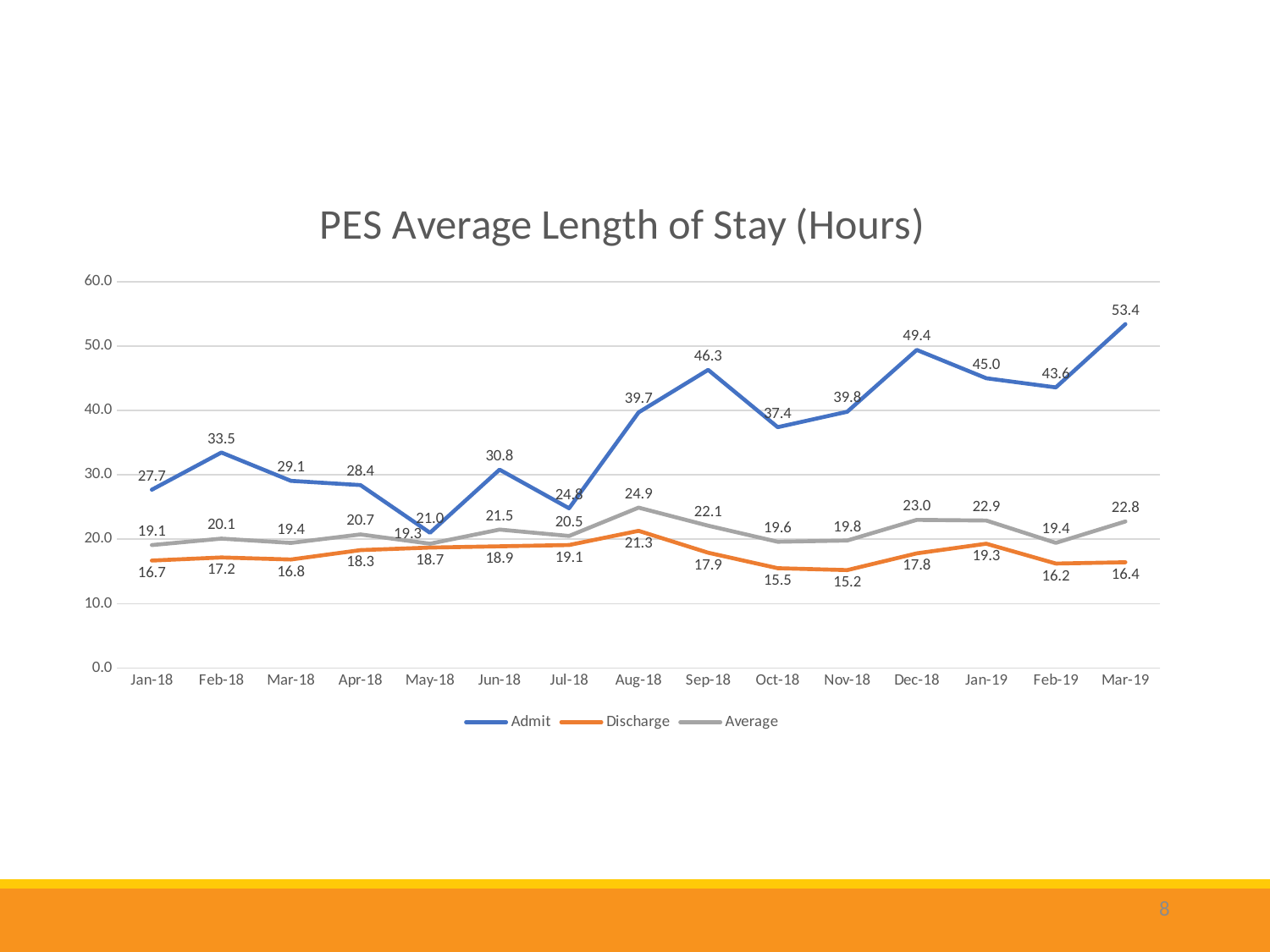
Which is larger, the Admit value in Feb-18 or the Admit value in Jun-18? Feb-18 What is the title of the chart? PES Average Length of Stay (Hours) What is the Discharge value for Aug-18? 21.3 Is the Admit value for Dec-18 greater or less than 40.0? greater How many months are shown on the x axis? 15 What is the Average value for Dec-18? 23.0 What kind of chart is shown on the slide? Line chart What is the Admit value for Mar-19? 53.4 In which month is the Discharge value lowest? Nov-18 In which month is the Admit value highest? Mar-19 How many series does the legend list? 3 What is the difference between the Admit and Discharge values in Sep-18? 28.4